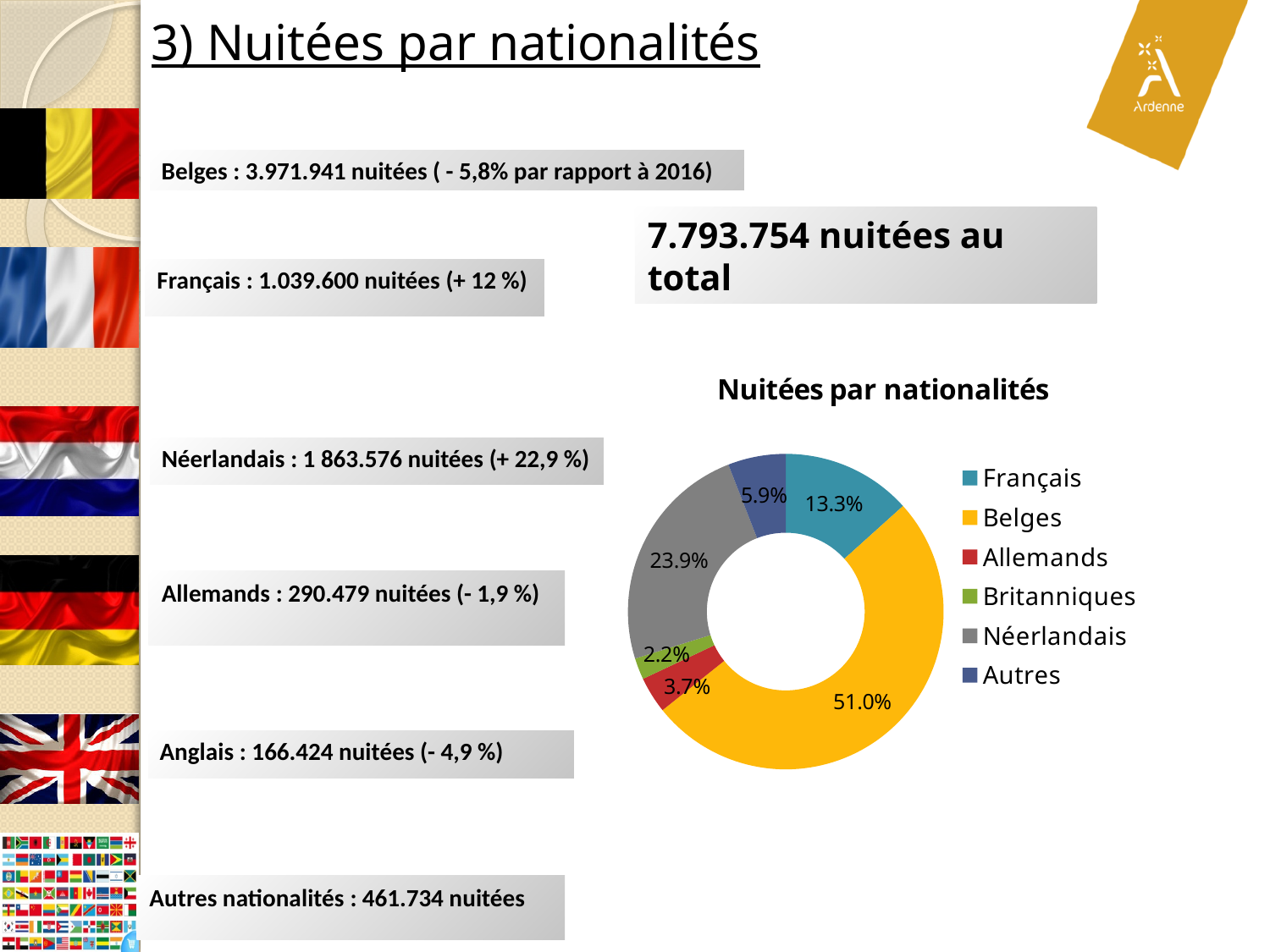
Which share is larger, Allemands or Autres? Autres What percentage does the chart show for Britanniques? 2.2% Which nationality has the smallest share in the chart? Britanniques What percentage does the chart show for Français? 13.3% What percentage does the chart show for Néerlandais? 23.9% Which nationality has the largest share in the chart? Belges What is the title of the chart? Nuitées par nationalités What kind of chart is shown on the slide? Doughnut chart What share of the doughnut chart is labelled for Belges? 51.0% Which colour represents Belges in the chart? Yellow What is the difference in percentage points between the Belges and Néerlandais shares? 27.1 How many categories does the chart's legend list? 6